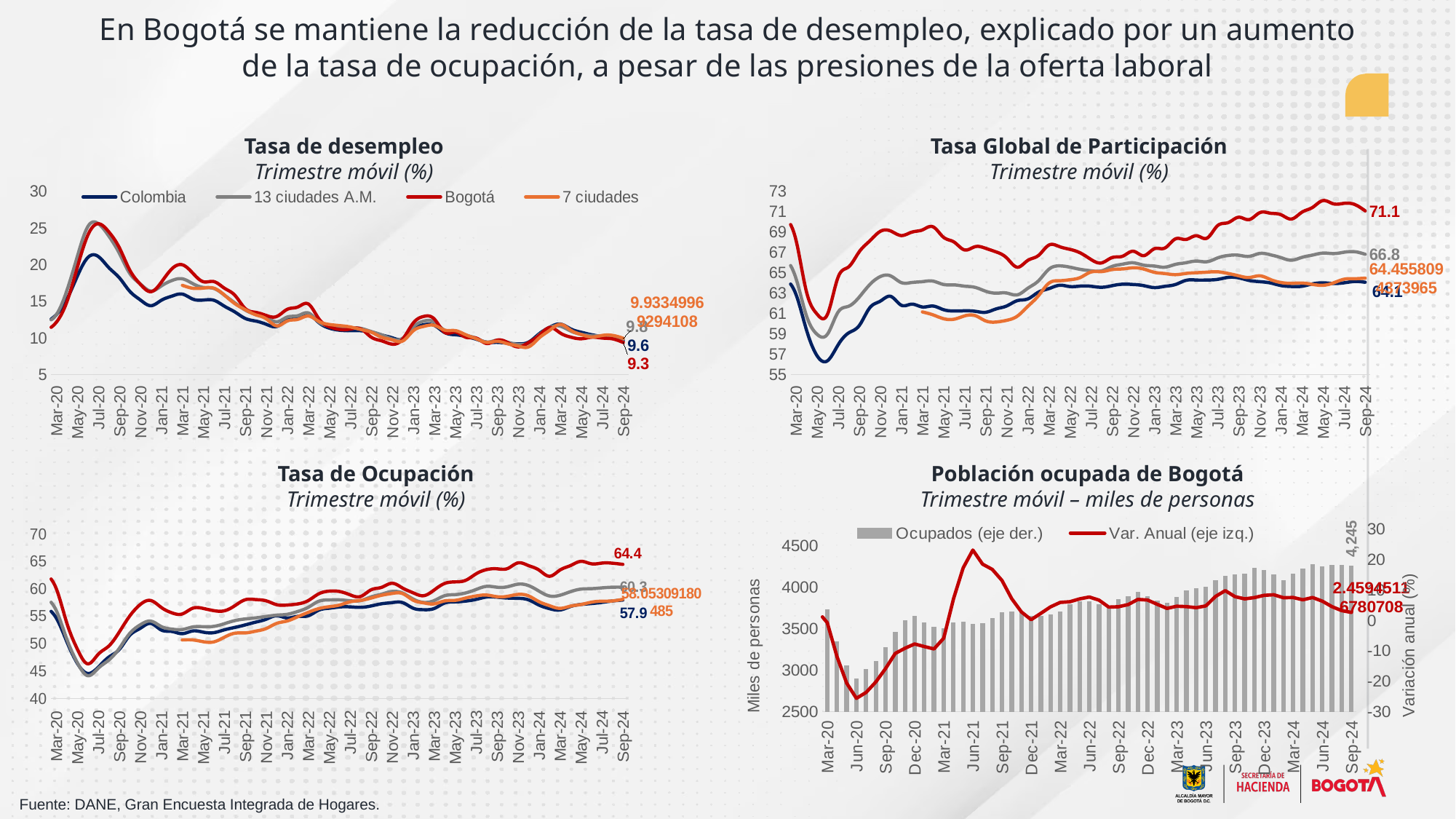
In the 'Tasa de Ocupación' chart, what is the final labelled value for Bogotá? 64.4 In the 'Tasa de desempleo' chart, is the peak value of the Bogotá line in 2020 greater or less than 20? greater In the 'Tasa de desempleo' chart, what is the final labelled value for Bogotá? 9.3 In the 'Tasa de Ocupación' chart, what is the difference between the final Bogotá value (64.4) and the final Colombia value (57.9)? 6.5 In the 'Tasa de desempleo' chart, what is the final labelled value for Colombia? 9.6 What kind of chart is the 'Tasa de desempleo' chart? line chart In the 'Tasa Global de Participación' chart, what is the final labelled value for Bogotá? 71.1 In the 'Población ocupada de Bogotá' chart, what is the labelled value of the last bar (Sep-24)? 4,245 How many series does the legend of the 'Tasa de desempleo' chart list? 4 In the 'Tasa de desempleo' chart, which is larger at the end of the series, Colombia or Bogotá? Colombia How many series does the legend of the 'Población ocupada de Bogotá' chart list? 2 In the 'Tasa Global de Participación' chart, what is the difference between the final Bogotá value (71.1) and the final 13 ciudades A.M. value (66.8)? 4.3